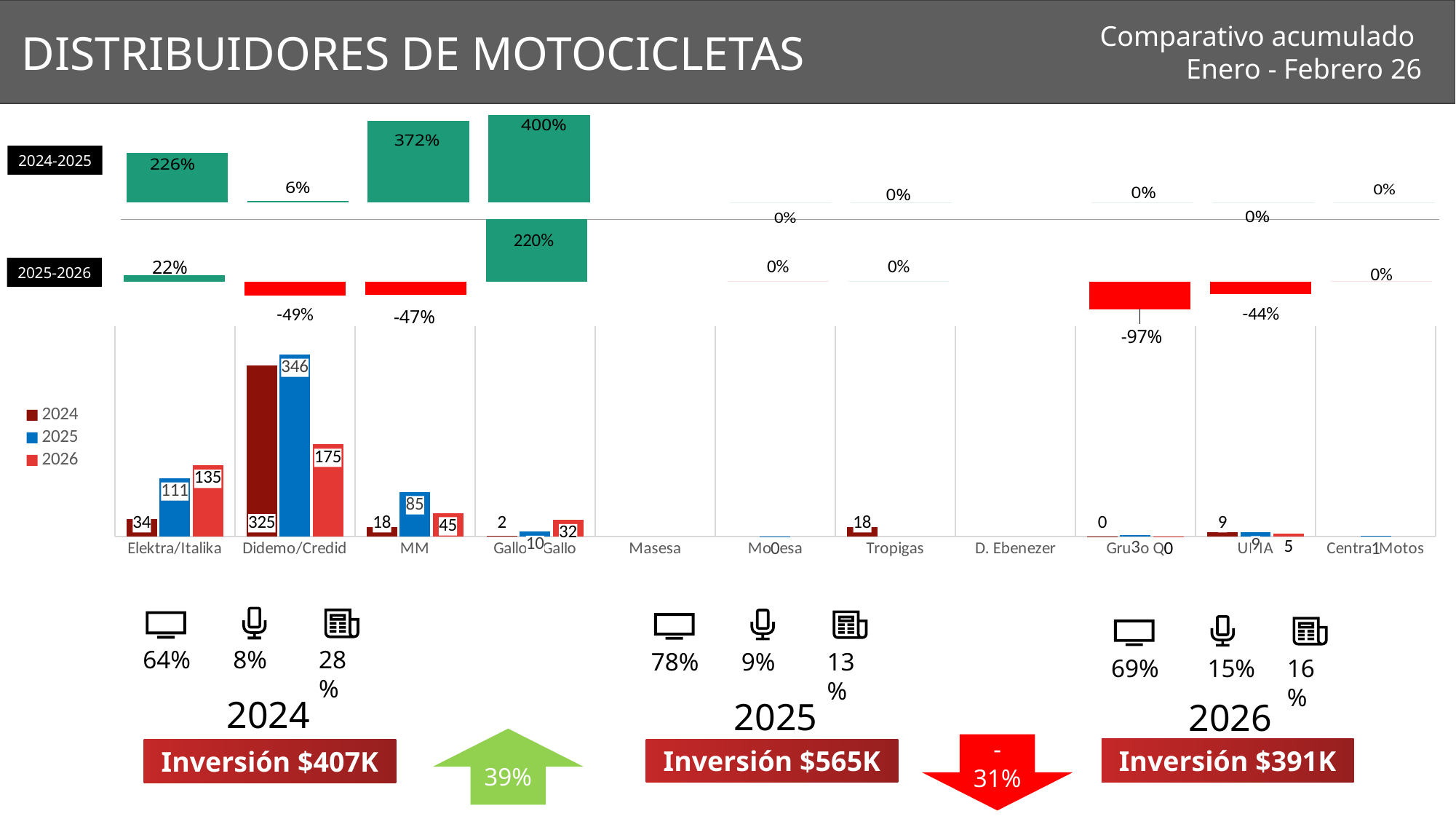
In the 2025-2026 comparison chart, what is the percentage change for MM? -47% What type of chart is used to show the distributor values by year? Bar chart In the bar chart, what is the 2026 value for Elektra/Italika? 135 In the bar chart, which distributor has the highest 2025 value? Didemo/Credid In the bar chart, what is the 2024 value for MM? 18 In the bar chart, which is larger for MM: the 2025 value or the 2026 value? 2025 In the bar chart, what is the difference between the 2025 and 2026 values for Didemo/Credid? 171 How many series does the legend of the bar chart list? 3 What is the Inversión value shown for 2025? $565K In the bar chart, what is the 2025 value for Didemo/Credid? 346 In the 2024-2025 comparison chart, what is the percentage change for Gallo Gallo? 400% In the 2024-2025 comparison chart, which distributor has the lowest positive percentage change among those with non-zero values? Didemo/Credid